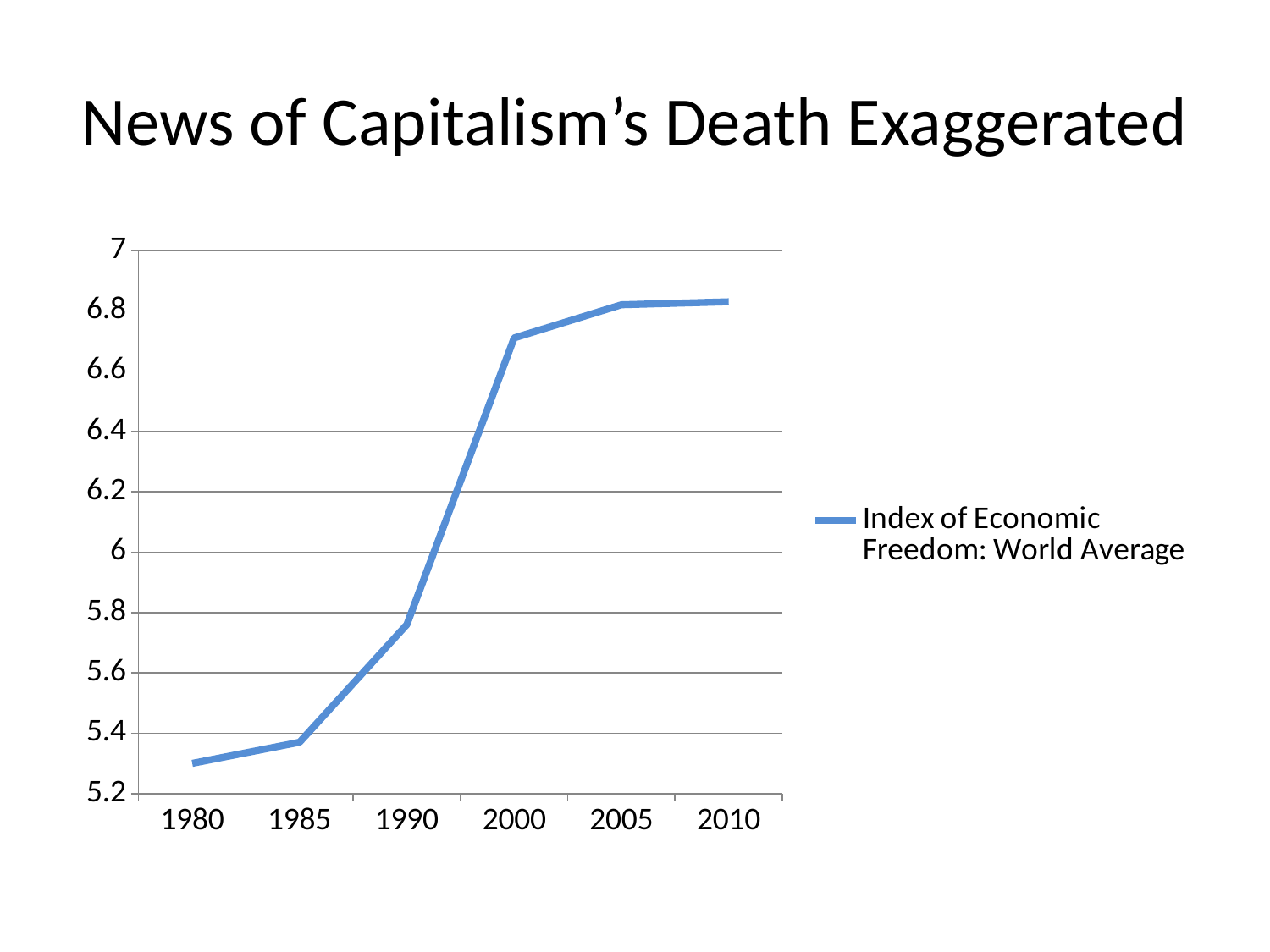
Is the value for 2010 greater or less than 6.8? greater Is the value for 2000 greater or less than 6.8? less Is the value for 1990 greater or less than 5.6? greater How many series does the legend list? 1 How many data points are plotted on the line? 6 Which year has the lowest value for the Index of Economic Freedom: World Average? 1980 Which is larger, the value for 1990 or the value for 2000? 2000 What is the name of the series shown in the legend? Index of Economic Freedom: World Average What is the title of the slide? News of Capitalism's Death Exaggerated Do the values rise or fall from 1980 to 2010? rise What kind of chart is shown on the slide? line chart